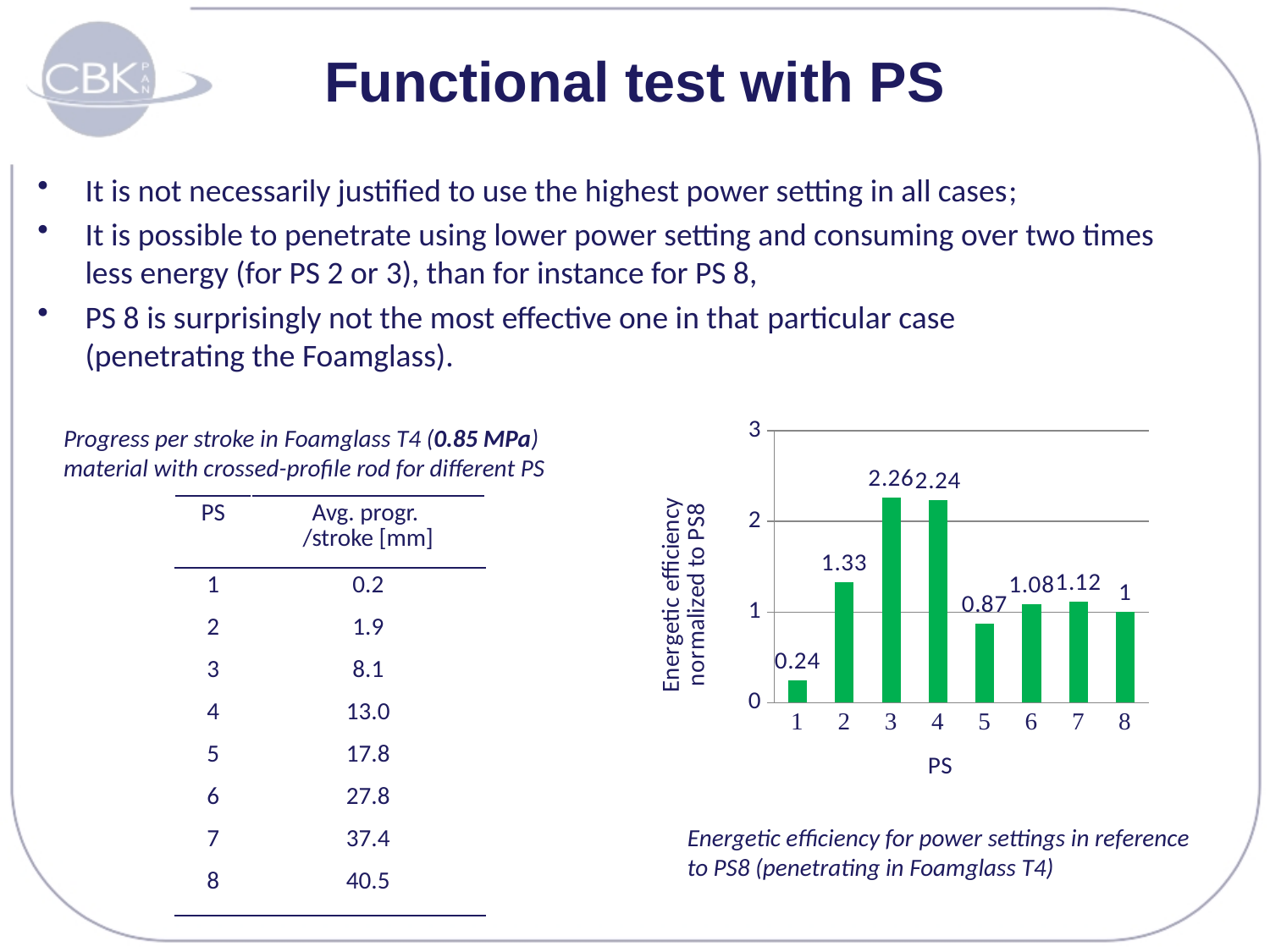
Which PS has the lowest energetic efficiency normalized to PS8? 1 Which PS has the highest energetic efficiency normalized to PS8? 3 What is the label of the x axis of the chart? PS What is the energetic efficiency normalized to PS8 for PS 8? 1 What is the energetic efficiency normalized to PS8 for PS 5? 0.87 Which has a higher energetic efficiency normalized to PS8, PS 2 or PS 6? PS 2 How many PS categories are plotted on the x axis of the chart? 8 What is the energetic efficiency normalized to PS8 for PS 3? 2.26 What is the difference between the energetic efficiency values for PS 2 and PS 1? 1.09 Is the energetic efficiency value for PS 4 greater or less than 2? greater What is the energetic efficiency normalized to PS8 for PS 1? 0.24 What kind of chart is shown on the slide? bar chart